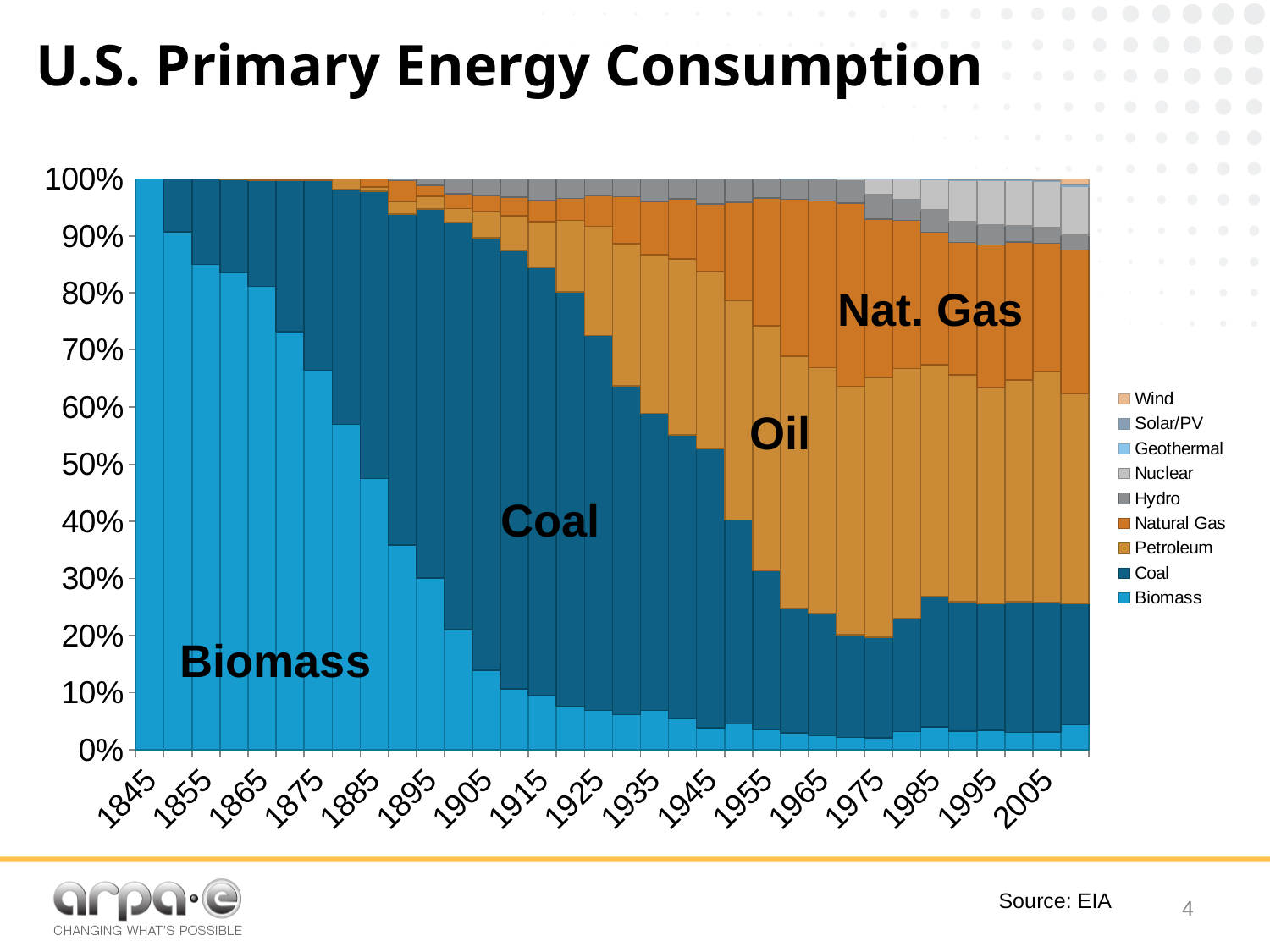
What kind of chart is shown on the slide? Stacked bar chart Does the Petroleum share rise or fall from 1905 to 1955? Rise Is the Biomass share in 1875 greater or less than 60%? greater What share of U.S. primary energy consumption does Biomass account for in 1845? 100% How many series does the legend list? 9 Is the Coal share in 1915 greater or less than 60%? greater Is the Coal share in 2005 greater or less than 30%? less What is the title of the chart? U.S. Primary Energy Consumption In 1975, which is larger: the Petroleum share or the Coal share? Petroleum Does the Biomass share rise or fall from 1845 to 1945? Fall Which series is listed at the bottom of the legend? Biomass